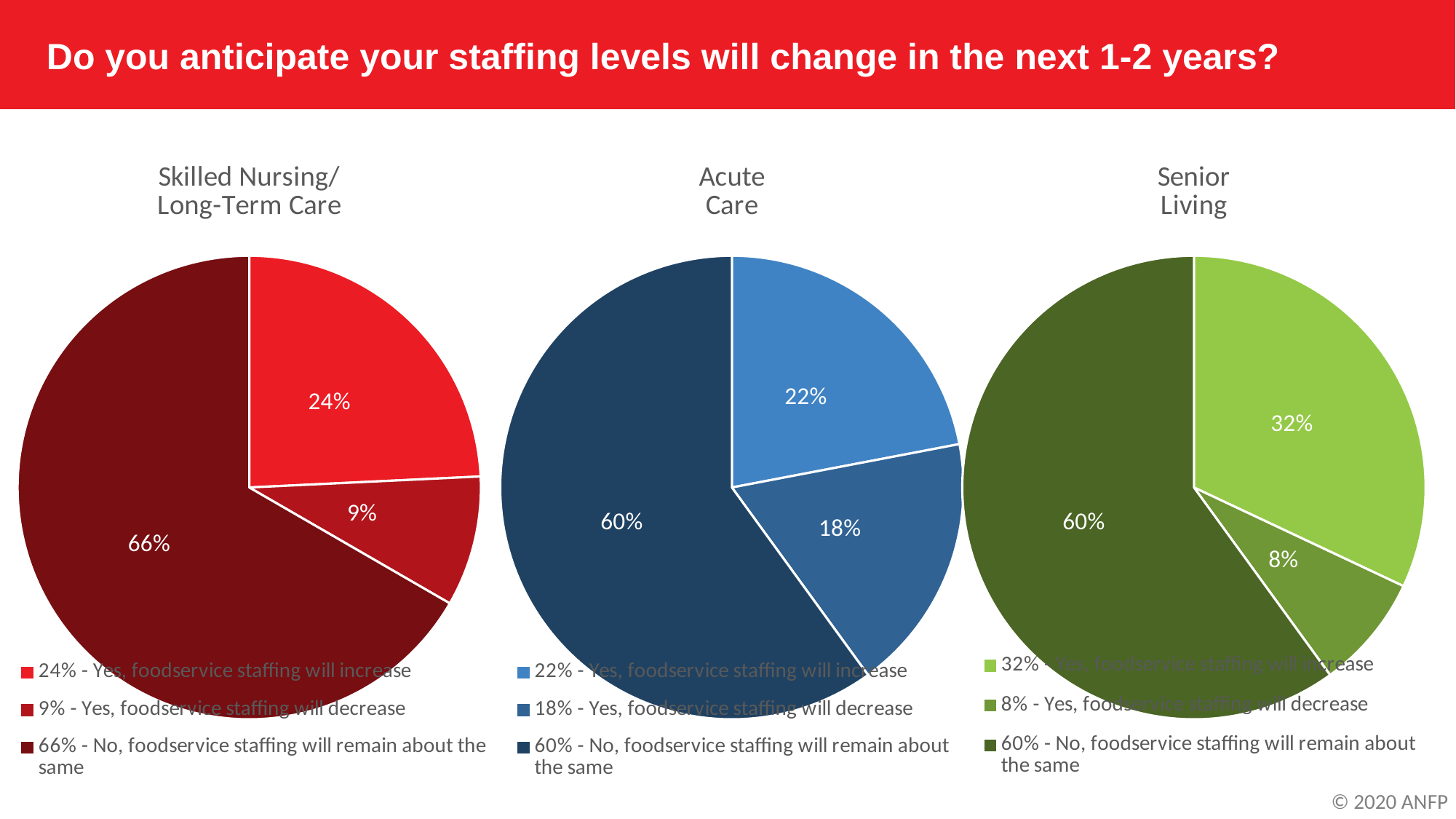
How many pie charts are shown on the slide? 3 How many slices does the Acute Care pie chart have? 3 Which is larger: the share saying staffing will increase in the Senior Living chart or in the Skilled Nursing/Long-Term Care chart? Senior Living In the Senior Living pie chart, what share of respondents said foodservice staffing will remain about the same? 60% What type of chart is used for the Senior Living data? Pie chart In the Skilled Nursing/Long-Term Care pie chart, which response has the smallest slice? Yes, foodservice staffing will decrease In the Senior Living pie chart, which response has the largest slice? No, foodservice staffing will remain about the same In the Skilled Nursing/Long-Term Care pie chart, what is the combined share of respondents who expect staffing to change (increase or decrease)? 33% In the Acute Care pie chart, what is the difference between the share saying staffing will increase and the share saying it will decrease? 4% In the Skilled Nursing/Long-Term Care pie chart, what share of respondents said foodservice staffing will increase? 24% What colour is the Acute Care pie chart drawn in? Blue In the Acute Care pie chart, what share of respondents said foodservice staffing will decrease? 18%